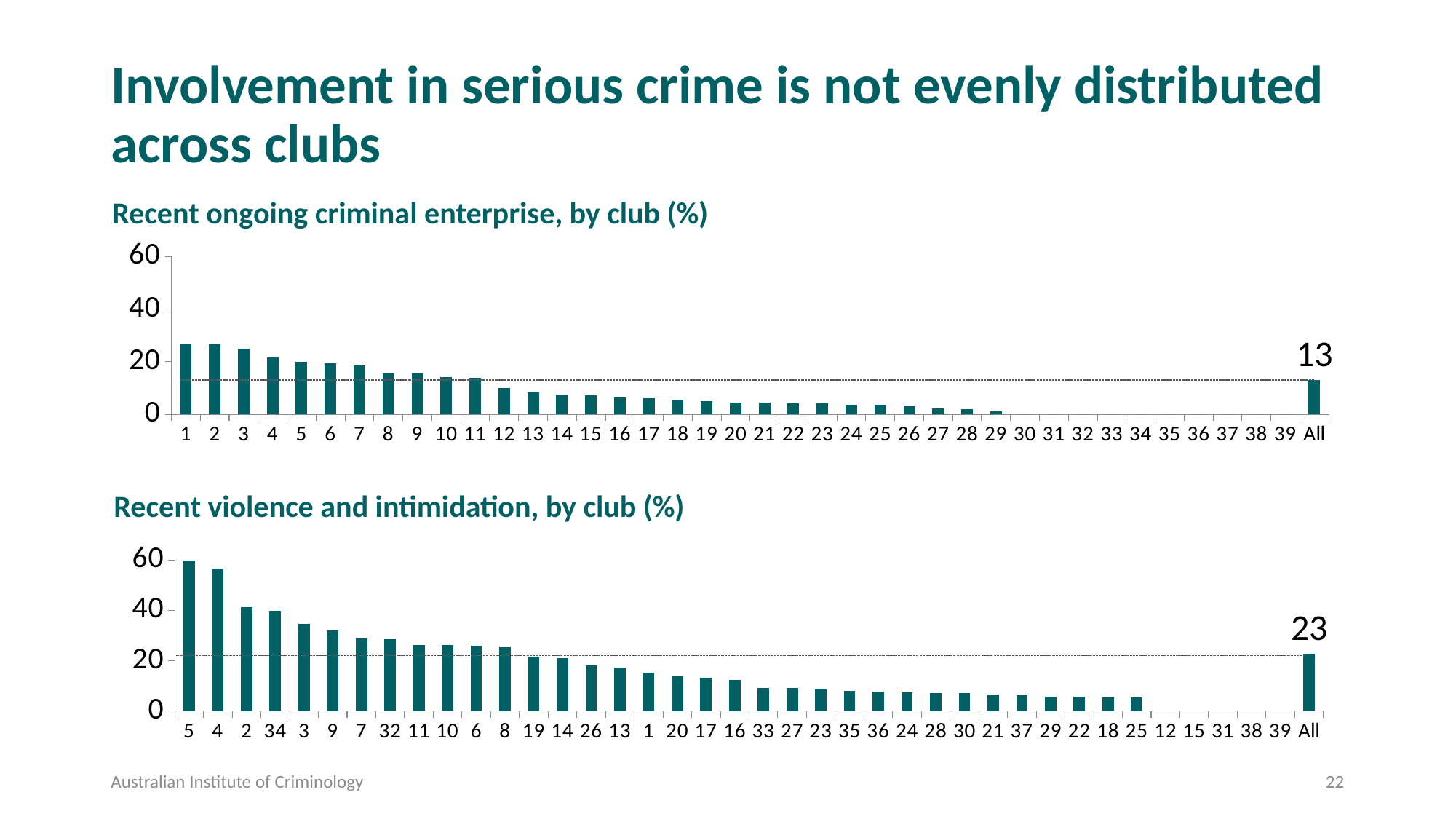
Which chart has the higher 'All' value: 'Recent ongoing criminal enterprise' or 'Recent violence and intimidation'? Recent violence and intimidation In the 'Recent ongoing criminal enterprise, by club (%)' chart, is the value for club 12 greater or less than 20? less In the 'Recent violence and intimidation, by club (%)' chart, do the club values rise or fall from left to right (excluding 'All')? Fall In the 'Recent violence and intimidation, by club (%)' chart, what is the value for 'All'? 23 In the 'Recent ongoing criminal enterprise, by club (%)' chart, what is the value for 'All'? 13 In the 'Recent violence and intimidation, by club (%)' chart, which is larger: the value for club 5 or the value for club 3? Club 5 What is the difference between the 'All' value in the 'Recent violence and intimidation' chart and the 'All' value in the 'Recent ongoing criminal enterprise' chart? 10 In the 'Recent violence and intimidation, by club (%)' chart, which club has the highest value? 5 In the 'Recent violence and intimidation, by club (%)' chart, is the value for club 3 greater or less than 40? less In the 'Recent ongoing criminal enterprise, by club (%)' chart, is the value for club 1 greater or less than 20? greater How many categories are labelled on the x axis of the 'Recent ongoing criminal enterprise, by club (%)' chart? 40 What kind of chart is the 'Recent violence and intimidation, by club (%)' chart? Bar chart